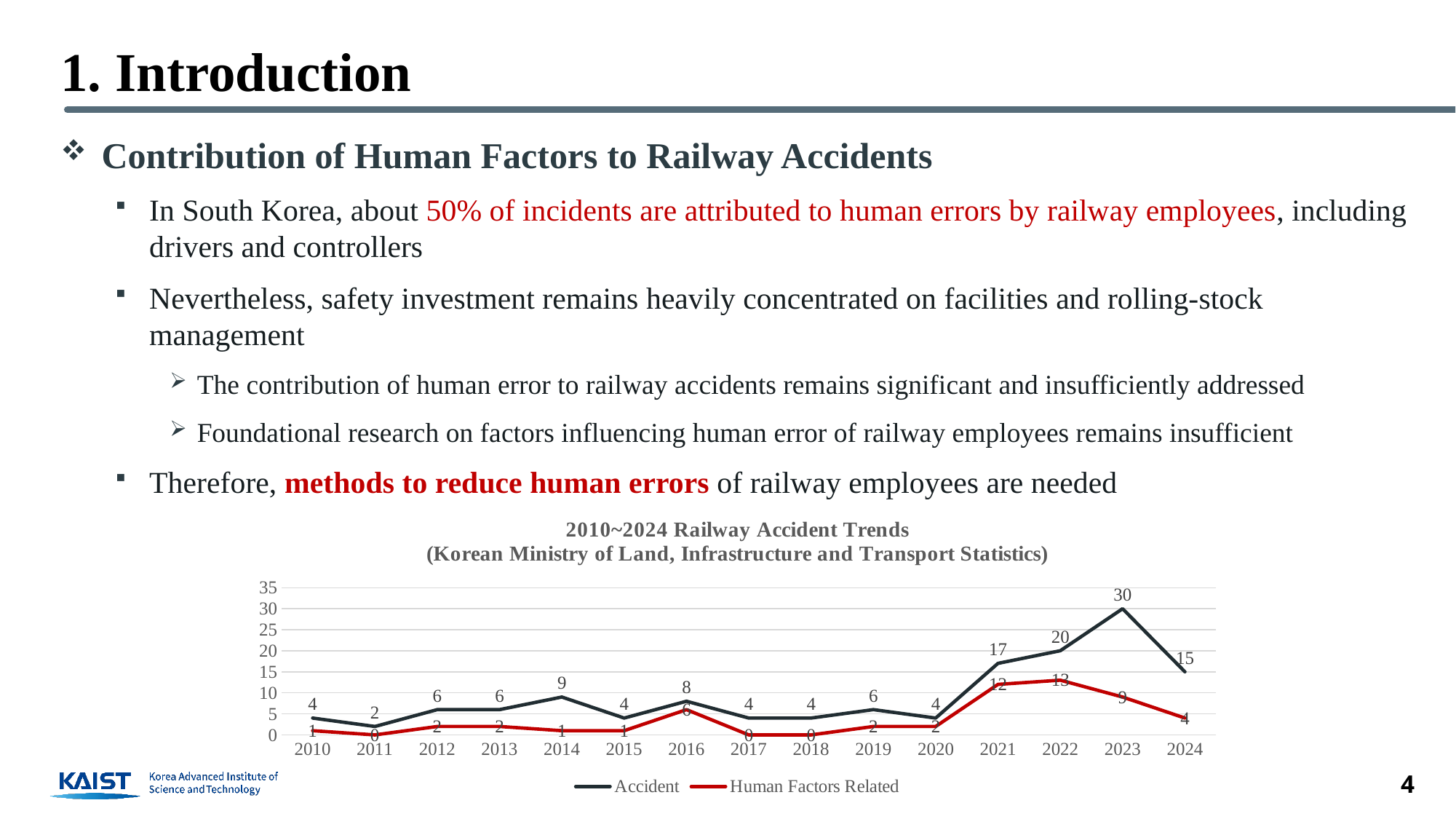
What is the Human Factors Related value for 2023? 9 What kind of chart is shown on the slide? line chart In which year is the Accident series highest? 2023 What is the Human Factors Related value for 2024? 4 In which year is the Accident series lowest? 2011 What is the Accident value for 2014? 9 Does the Accident series rise or fall from 2020 to 2023? rise How many years are plotted on the x axis? 15 What is the Accident value for 2023? 30 Which is larger, the Accident value for 2022 or the Accident value for 2024? 2022 What is the difference between the Accident value and the Human Factors Related value in 2023? 21 How many series does the legend list? 2